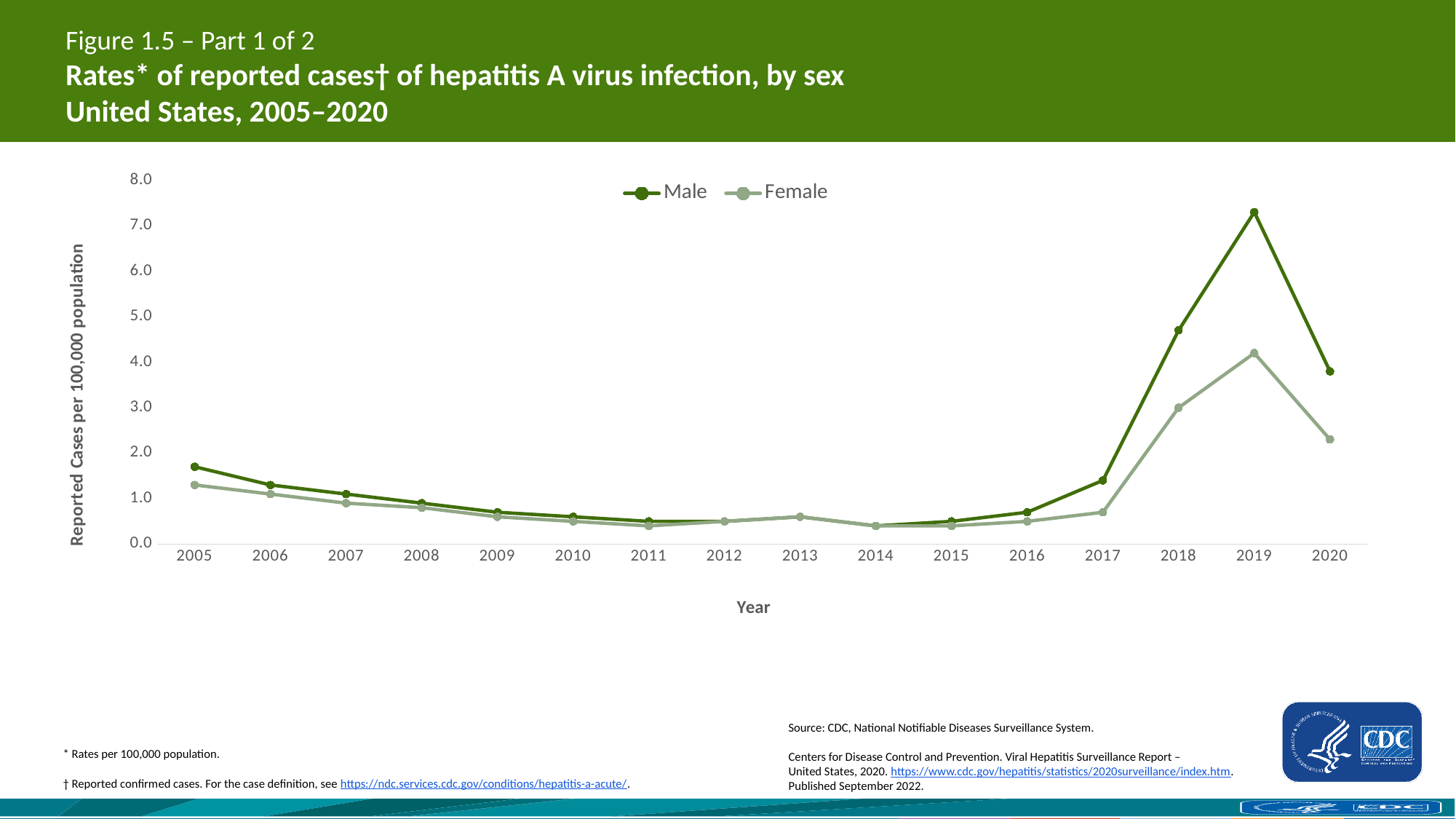
Is the Male rate in 2020 greater or less than 4.0? less What kind of chart is shown on the slide? line chart Does the Male rate rise or fall from 2005 to 2011? fall How many years are plotted along the x axis? 16 Is the Female rate in 2019 greater or less than 4.0? greater How many series does the legend list? 2 Is the Male rate in 2018 greater or less than 5.0? less What is the label of the y axis? Reported Cases per 100,000 population Which series has the larger rate in 2018, Male or Female? Male In which year is the Male rate highest? 2019 In which year is the Female rate highest? 2019